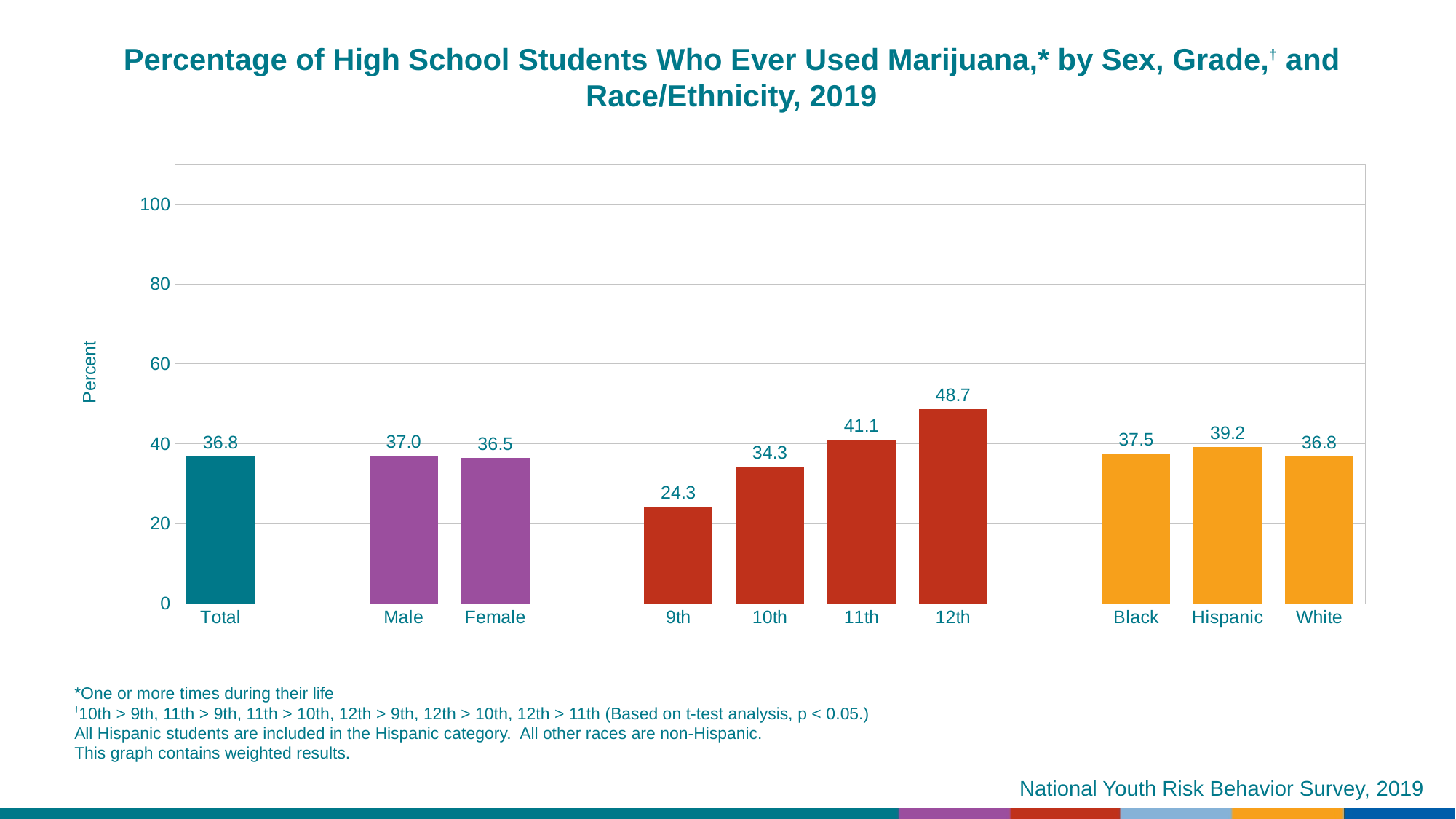
What kind of chart is this? bar chart How many categories are shown on the x axis? 10 What is the label on the y axis? Percent What is the value for Total? 36.8 What is the difference between the values for Hispanic and White students? 2.4 Which is larger, the value for 11th grade or the value for 10th grade? 11th Which category has the highest value? 12th What is the value for Hispanic students? 39.2 What is the value for 9th grade? 24.3 Is the value for 12th grade greater or less than 40? greater Which category has the lowest value? 9th What is the difference between the values for 12th and 9th grade? 24.4